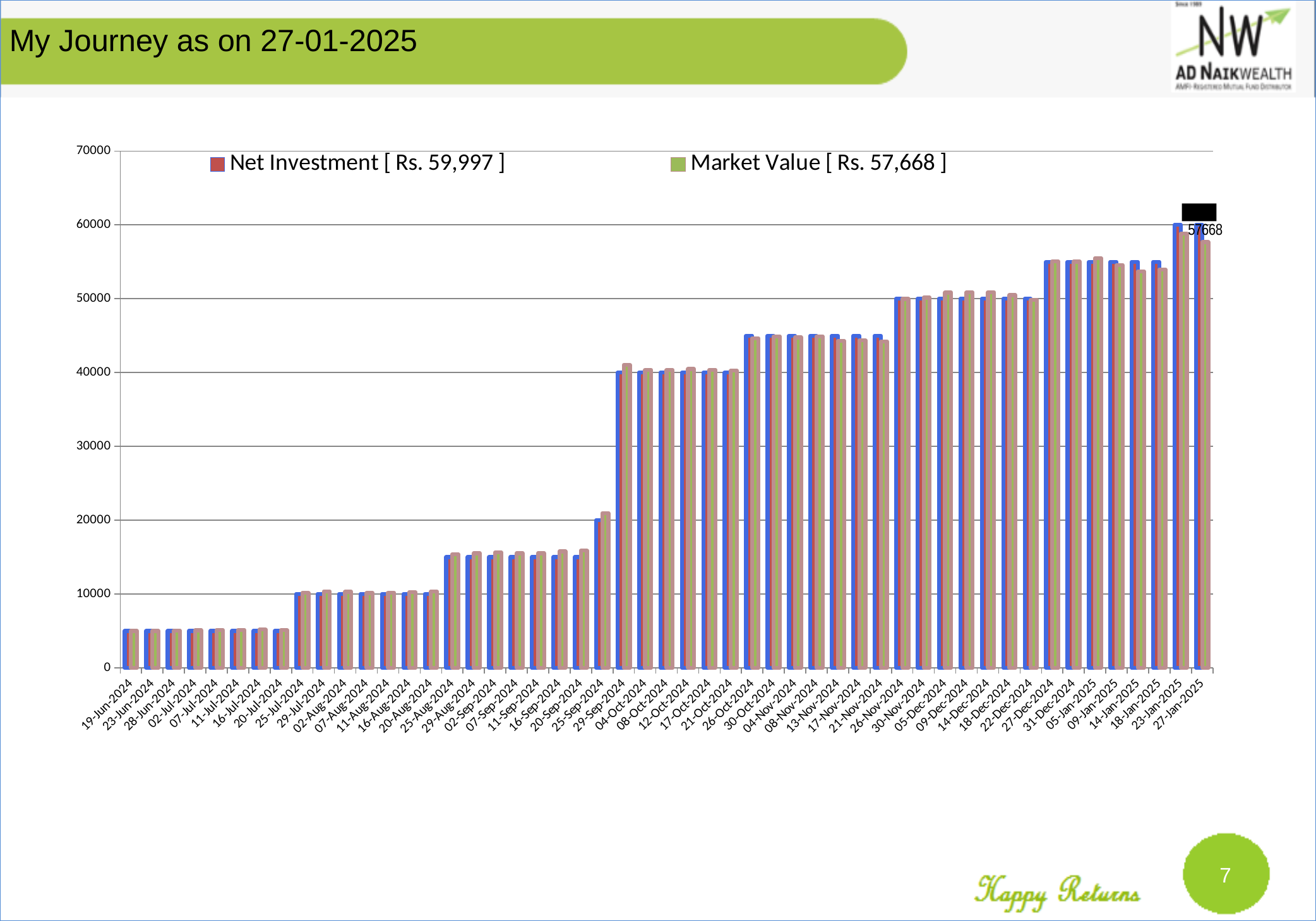
On 27-Jan-2025, which is larger, Net Investment or Market Value? Net Investment Is the Net Investment value for 19-Jun-2024 greater or less than 10000? less Do the Net Investment values generally rise or fall from 19-Jun-2024 to 27-Jan-2025? rise How many series does the chart legend list? 2 On which date is the Net Investment highest? 23-Jan-2025 and 27-Jan-2025 What is the difference between the Net Investment and the Market Value shown in the legend? Rs. 2,329 What Net Investment amount is shown in the legend? Rs. 59,997 Is the Net Investment value for 04-Oct-2024 greater or less than 30000? greater What is the title of the slide containing the chart? My Journey as on 27-01-2025 What kind of chart is shown on the slide? bar chart What is the Market Value on 27-Jan-2025 according to the data label? 57668 Is the Market Value for 25-Sep-2024 greater or less than 20000? greater